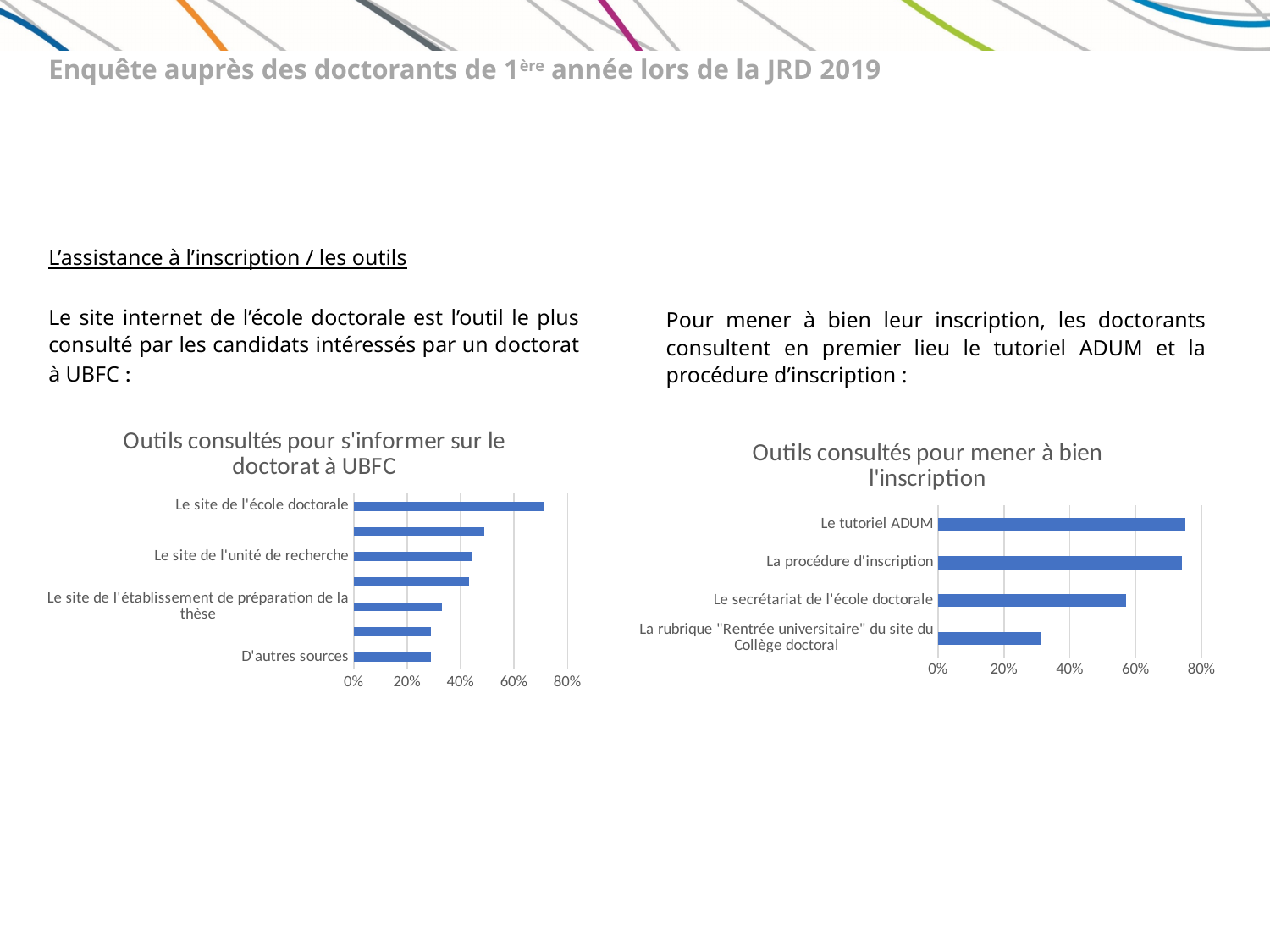
What is the title of the chart on the left of the slide? Outils consultés pour s'informer sur le doctorat à UBFC In the chart 'Outils consultés pour s'informer sur le doctorat à UBFC', is the value for 'Le site de l'école doctorale' greater or less than 60%? greater In the chart 'Outils consultés pour mener à bien l'inscription', which is larger: 'Le secrétariat de l'école doctorale' or 'La rubrique "Rentrée universitaire" du site du Collège doctoral'? Le secrétariat de l'école doctorale In the chart 'Outils consultés pour s'informer sur le doctorat à UBFC', which category has the highest value? Le site de l'école doctorale What kind of chart is 'Outils consultés pour mener à bien l'inscription'? bar chart How many categories are shown in the chart 'Outils consultés pour mener à bien l'inscription'? 4 What colour are the bars in the chart 'Outils consultés pour mener à bien l'inscription'? blue In the chart 'Outils consultés pour mener à bien l'inscription', which category has the lowest value? La rubrique "Rentrée universitaire" du site du Collège doctoral In the chart 'Outils consultés pour s'informer sur le doctorat à UBFC', which is larger: 'Le site de l'école doctorale' or 'Le site de l'unité de recherche'? Le site de l'école doctorale In the chart 'Outils consultés pour s'informer sur le doctorat à UBFC', is the value for 'D'autres sources' greater or less than 40%? less In the chart 'Outils consultés pour mener à bien l'inscription', is the value for 'La rubrique "Rentrée universitaire" du site du Collège doctoral' greater or less than 40%? less